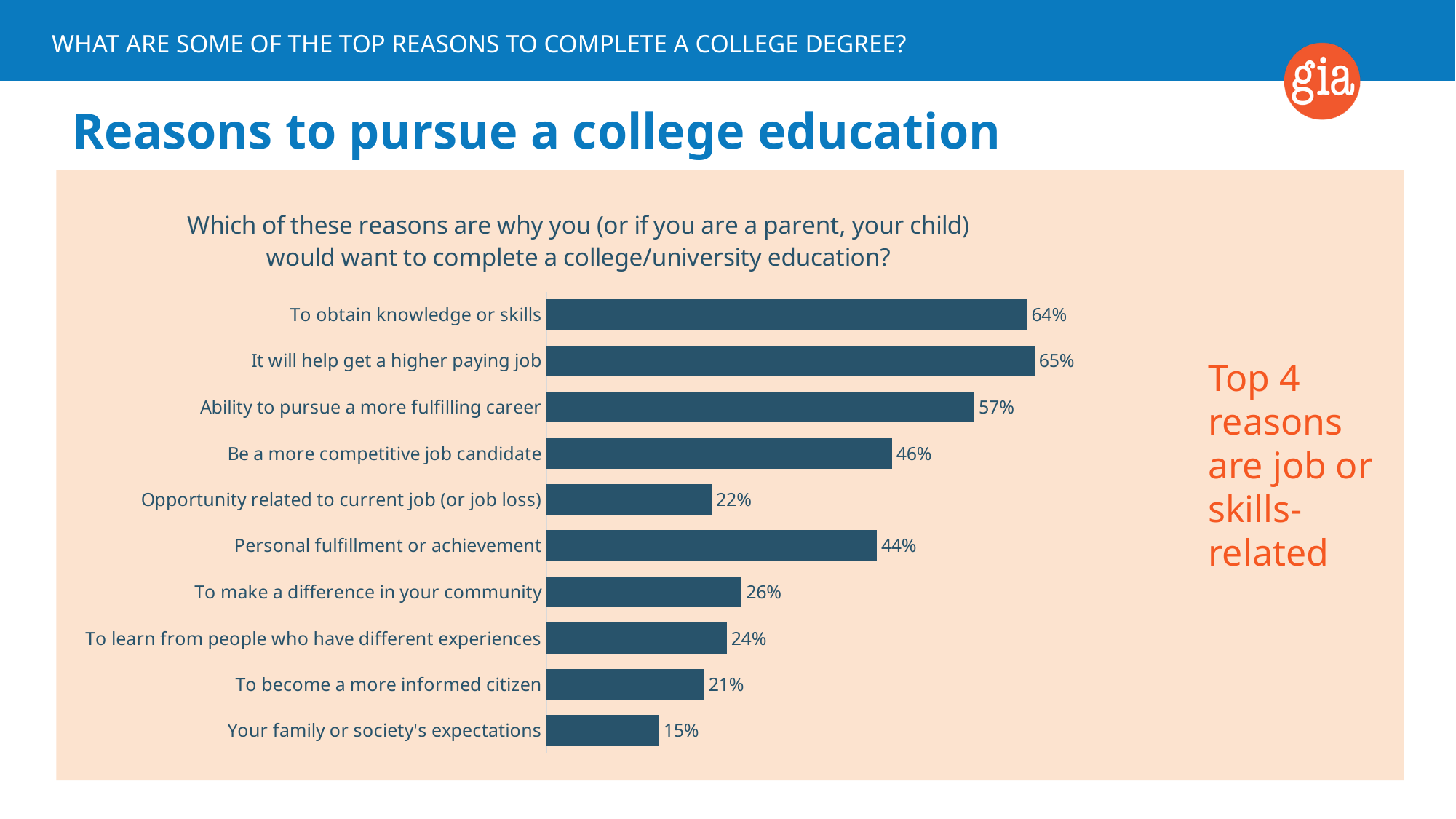
What percentage is shown for "Your family or society's expectations"? 15% What is the difference between "To obtain knowledge or skills" and "To become a more informed citizen"? 43% Which reason has the lowest percentage? Your family or society's expectations What is the value for "Be a more competitive job candidate"? 46% How many reasons are listed in the chart? 10 What is the difference between "Ability to pursue a more fulfilling career" and "Personal fulfillment or achievement"? 13% What percentage of respondents chose "To obtain knowledge or skills" as a reason? 64% What is the value for "Opportunity related to current job (or job loss)"? 22% Which is larger: "To make a difference in your community" or "To learn from people who have different experiences"? To make a difference in your community What does the orange text to the right of the chart say? Top 4 reasons are job or skills-related What kind of chart is shown on the slide? Bar chart Which reason has the highest percentage? It will help get a higher paying job